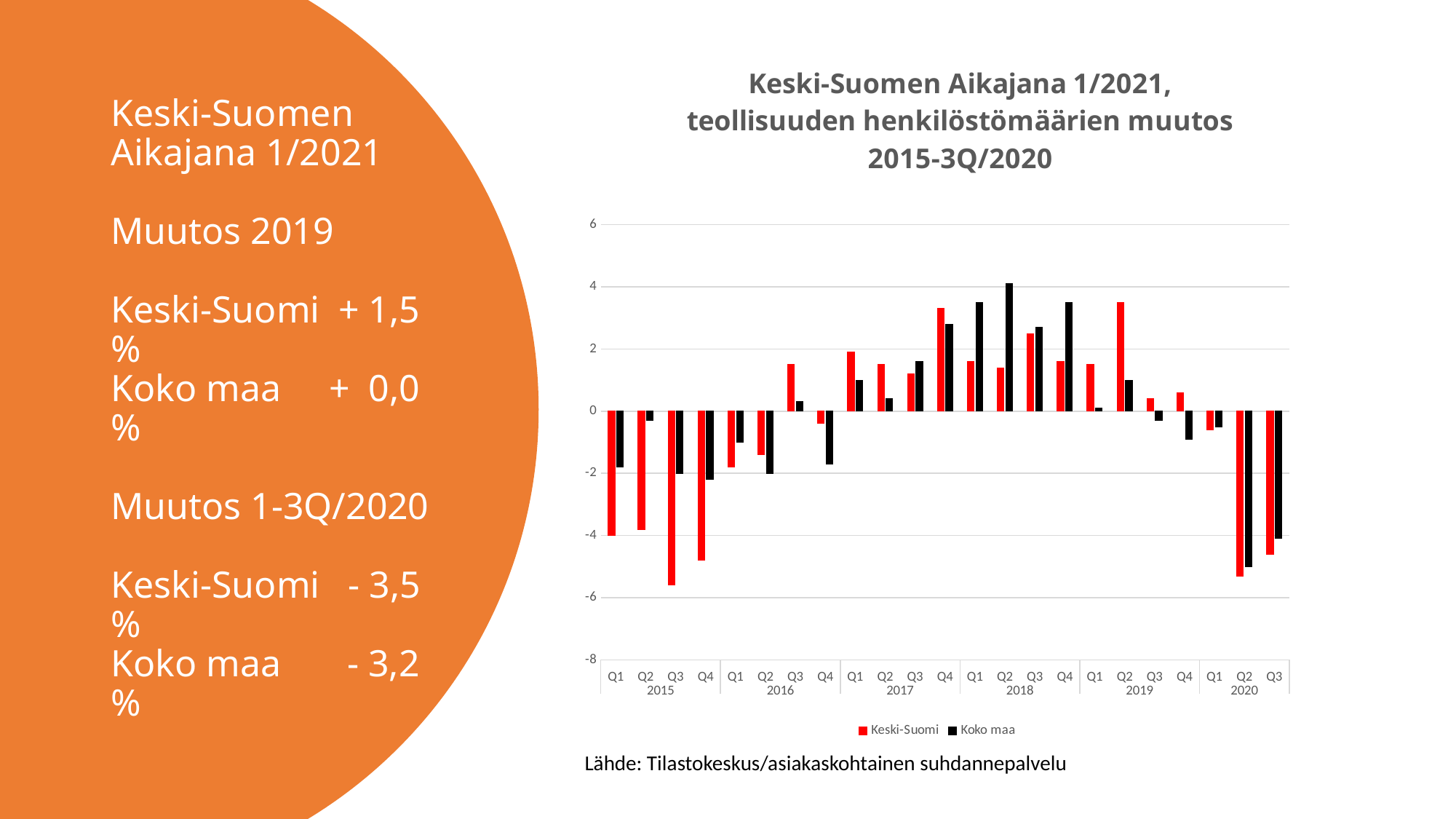
What is the source cited below the chart? Tilastokeskus/asiakaskohtainen suhdannepalvelu Do the Koko maa values rise or fall from Q1 2020 to Q2 2020? fall In Q2 2018, which series has the larger value, Keski-Suomi or Koko maa? Koko maa Which series is shown in red in the chart? Keski-Suomi Is the Koko maa value for Q4 2018 greater or less than 2? greater Is the Koko maa value for Q2 2018 greater or less than 2? greater In Q2 2019, which series has the larger value, Keski-Suomi or Koko maa? Keski-Suomi In which quarter does the Koko maa series reach its highest value? Q2 2018 What kind of chart is shown on the slide? bar chart How many quarterly categories are plotted along the x axis of the chart? 23 Is the Keski-Suomi value for Q3 2015 greater or less than -4? less How many series does the chart legend list? 2